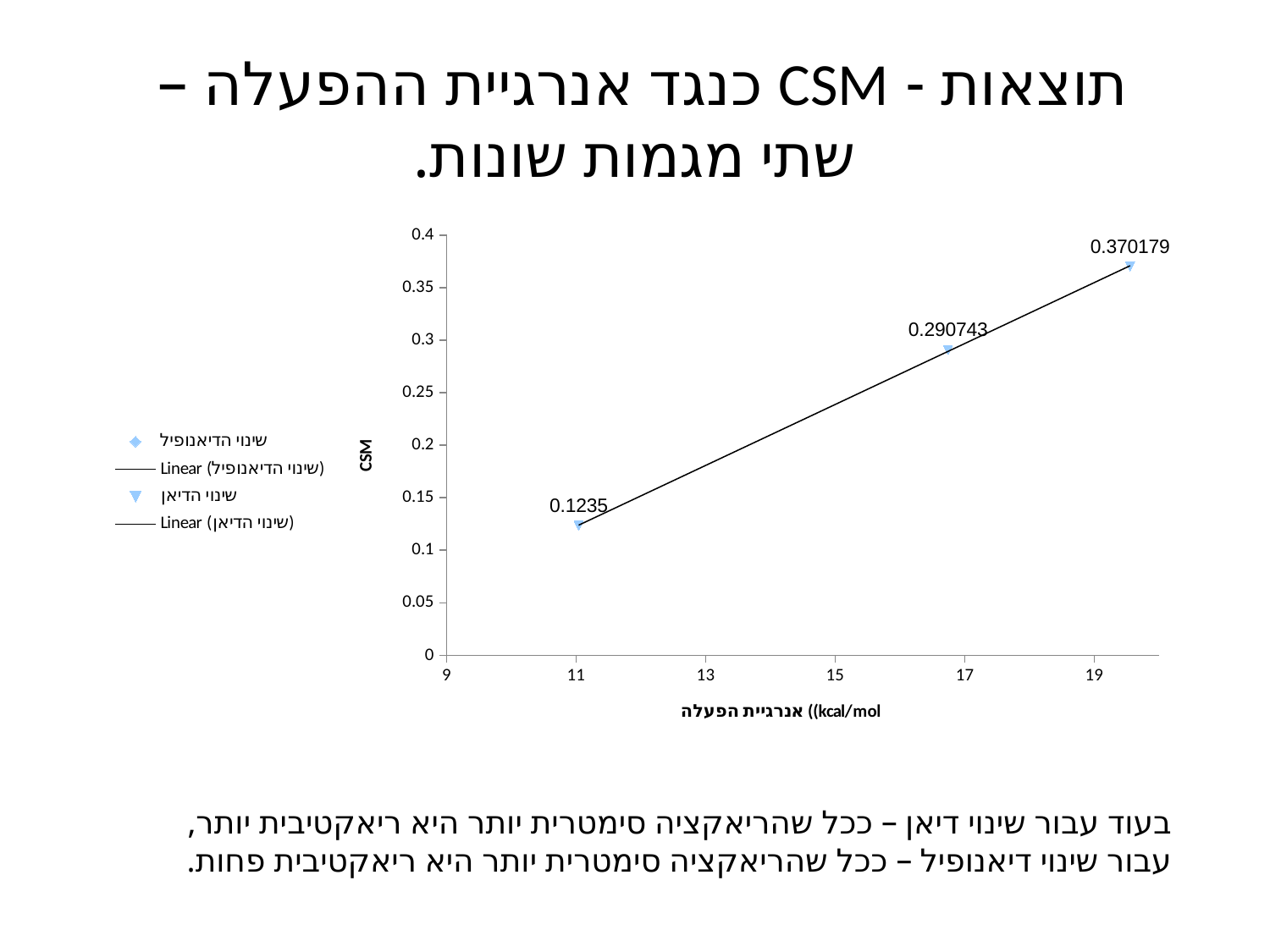
What is the CSM value of the rightmost data point on the chart? 0.370179 Do the CSM values rise or fall as activation energy increases along the x axis? rise What type of chart is shown on the slide? scatter chart What is the label of the x axis? אנרגיית הפעלה (kcal/mol) What is the difference between the highest CSM value (0.370179) and the lowest CSM value (0.1235)? 0.246679 How many data points are plotted on the chart? 3 Which data point has the lowest CSM value? the leftmost point, 0.1235 What is the CSM value of the middle data point on the chart? 0.290743 What is the CSM value of the leftmost data point (at activation energy 11 kcal/mol)? 0.1235 Is the CSM value of the rightmost data point greater or less than 0.35? greater Which data point has the highest CSM value? the rightmost point, 0.370179 What is the difference between the CSM values 0.370179 and 0.290743? 0.079436